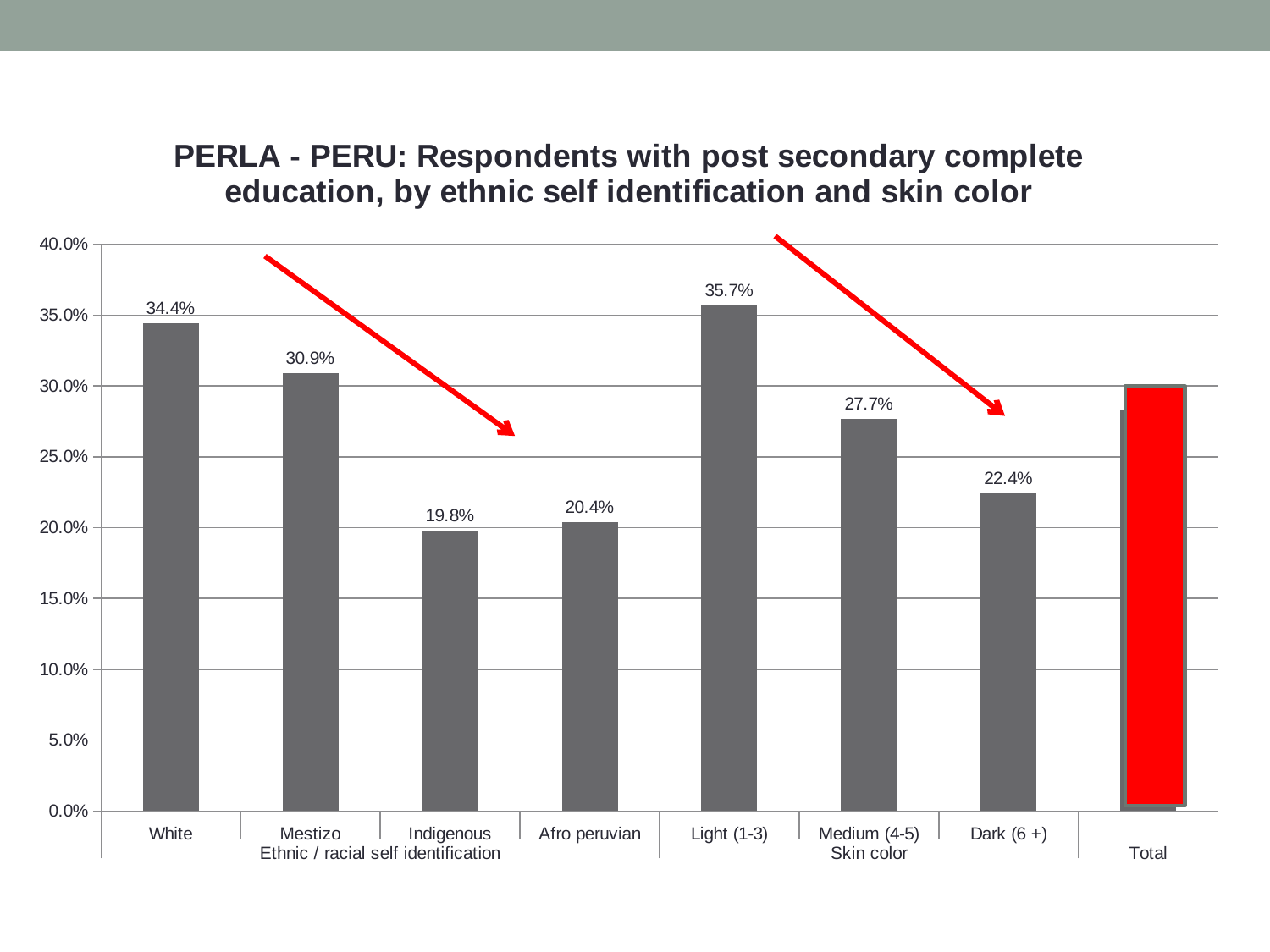
What is the value shown for Mestizo respondents? 30.9% Which category has the lowest value in the chart? Indigenous Which category has the highest value in the chart? Light (1-3) What kind of chart is shown on the slide? bar chart Do the values rise or fall across the skin color categories from Light (1-3) to Dark (6 +)? fall What is the difference between the values for Light (1-3) and Dark (6 +)? 13.3% Which is larger, the value for Afro peruvian or the value for Indigenous? Afro peruvian What is the value shown for the Medium (4-5) skin color category? 27.7% How many categories are shown on the x axis of the chart? 8 What is the difference between the values for White and Mestizo respondents? 3.5% What percentage of White respondents have post secondary complete education? 34.4%